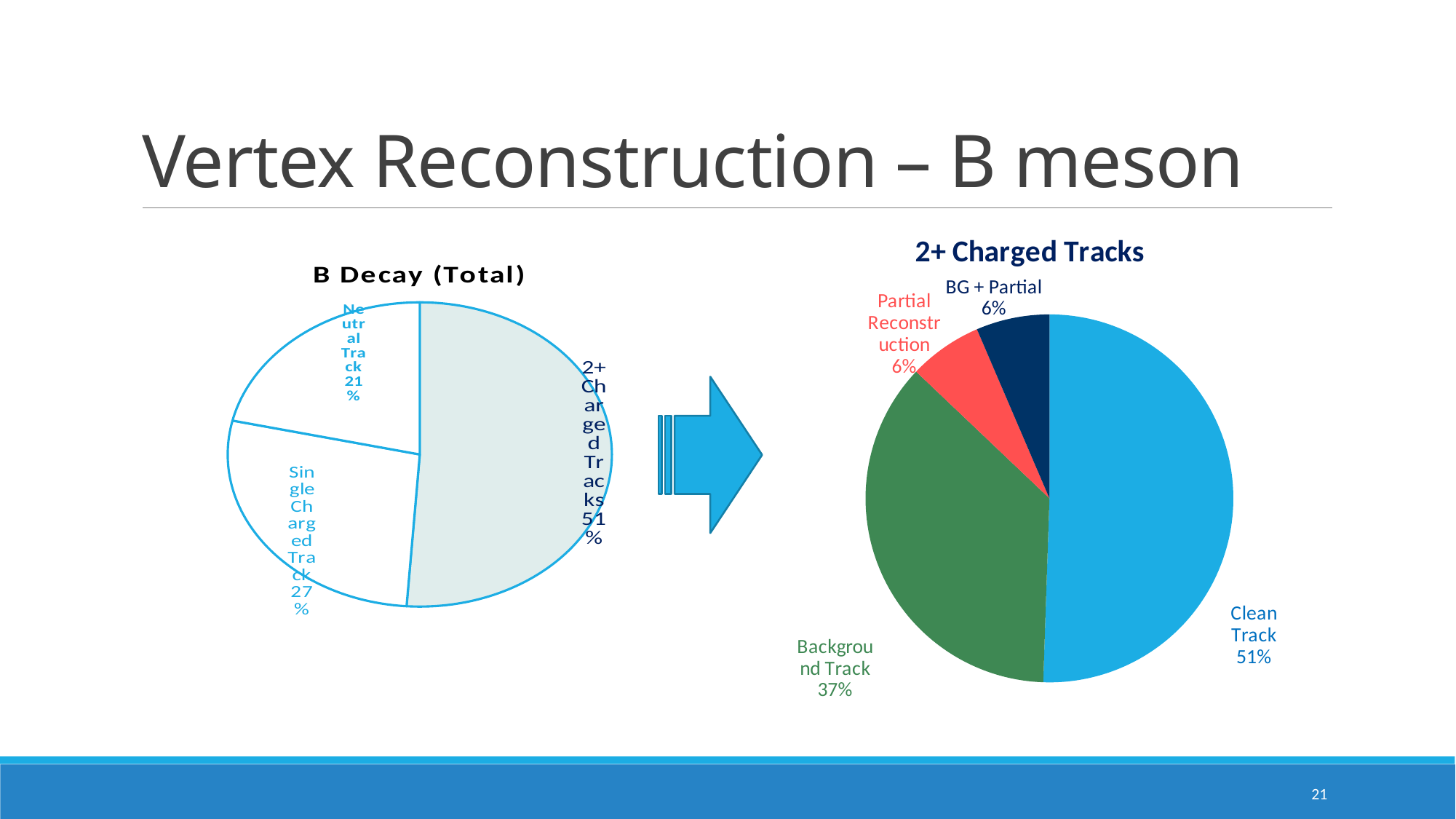
In the '2+ Charged Tracks' chart, what percentage is labelled for 'Partial Reconstruction'? 6% In the '2+ Charged Tracks' chart, what is the difference in percentage points between 'Clean Track' and 'Background Track'? 14 In the 'B Decay (Total)' chart, which slice is the smallest? Neutral Track In the 'B Decay (Total)' chart, how many slices does the pie have? 3 In the 'B Decay (Total)' chart, what percentage is labelled for 'Neutral Track'? 21% What kind of chart is the chart titled '2+ Charged Tracks'? Pie chart In the 'B Decay (Total)' chart, which slice is the largest? 2+ Charged Tracks In the '2+ Charged Tracks' chart, how many slices does the pie have? 4 In the 'B Decay (Total)' chart, what share of the pie is '2+ Charged Tracks'? 51% In the '2+ Charged Tracks' chart, what share of the pie is 'Clean Track'? 51% In the 'B Decay (Total)' chart, what percentage is labelled for 'Single Charged Track'? 27% In the '2+ Charged Tracks' chart, what percentage is labelled for 'Background Track'? 37%